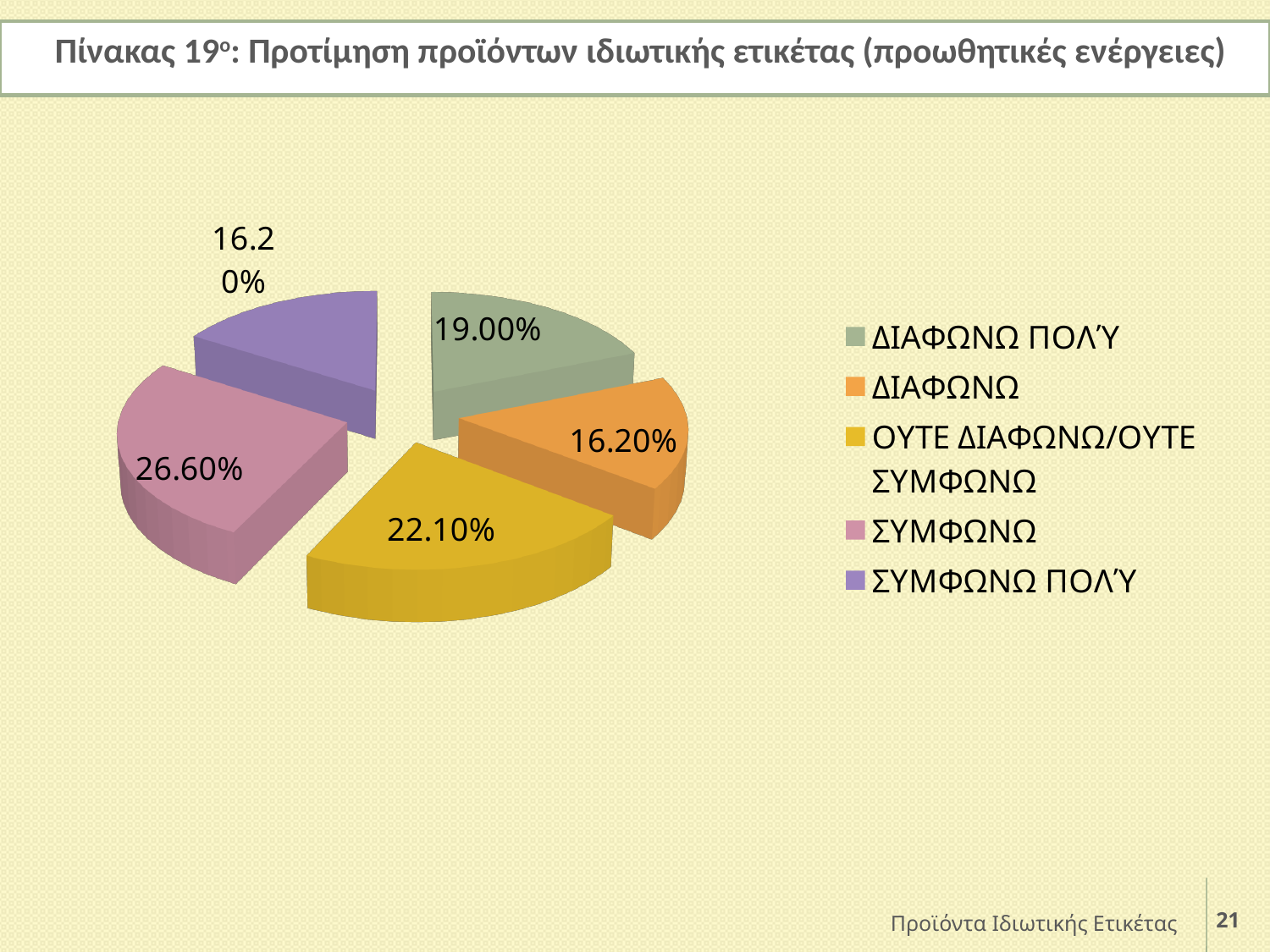
What colour is the slice for ΟΥΤΕ ΔΙΑΦΩΝΩ/ΟΥΤΕ ΣΥΜΦΩΝΩ? yellow What percentage is shown for ΣΥΜΦΩΝΩ ΠΟΛΎ? 16.20% Which is larger, the share for ΣΥΜΦΩΝΩ or the share for ΔΙΑΦΩΝΩ ΠΟΛΎ? ΣΥΜΦΩΝΩ What percentage is shown for ΣΥΜΦΩΝΩ? 26.60% What percentage is shown for ΟΥΤΕ ΔΙΑΦΩΝΩ/ΟΥΤΕ ΣΥΜΦΩΝΩ? 22.10% Which category has the largest share of the pie? ΣΥΜΦΩΝΩ How many slices does the pie chart have? 5 What type of chart is shown on the slide? pie chart What percentage is shown for ΔΙΑΦΩΝΩ? 16.20% What is the combined share of ΣΥΜΦΩΝΩ and ΣΥΜΦΩΝΩ ΠΟΛΎ? 42.80% What percentage is shown for ΔΙΑΦΩΝΩ ΠΟΛΎ? 19.00% What is the difference in percentage points between ΣΥΜΦΩΝΩ and ΟΥΤΕ ΔΙΑΦΩΝΩ/ΟΥΤΕ ΣΥΜΦΩΝΩ? 4.50%